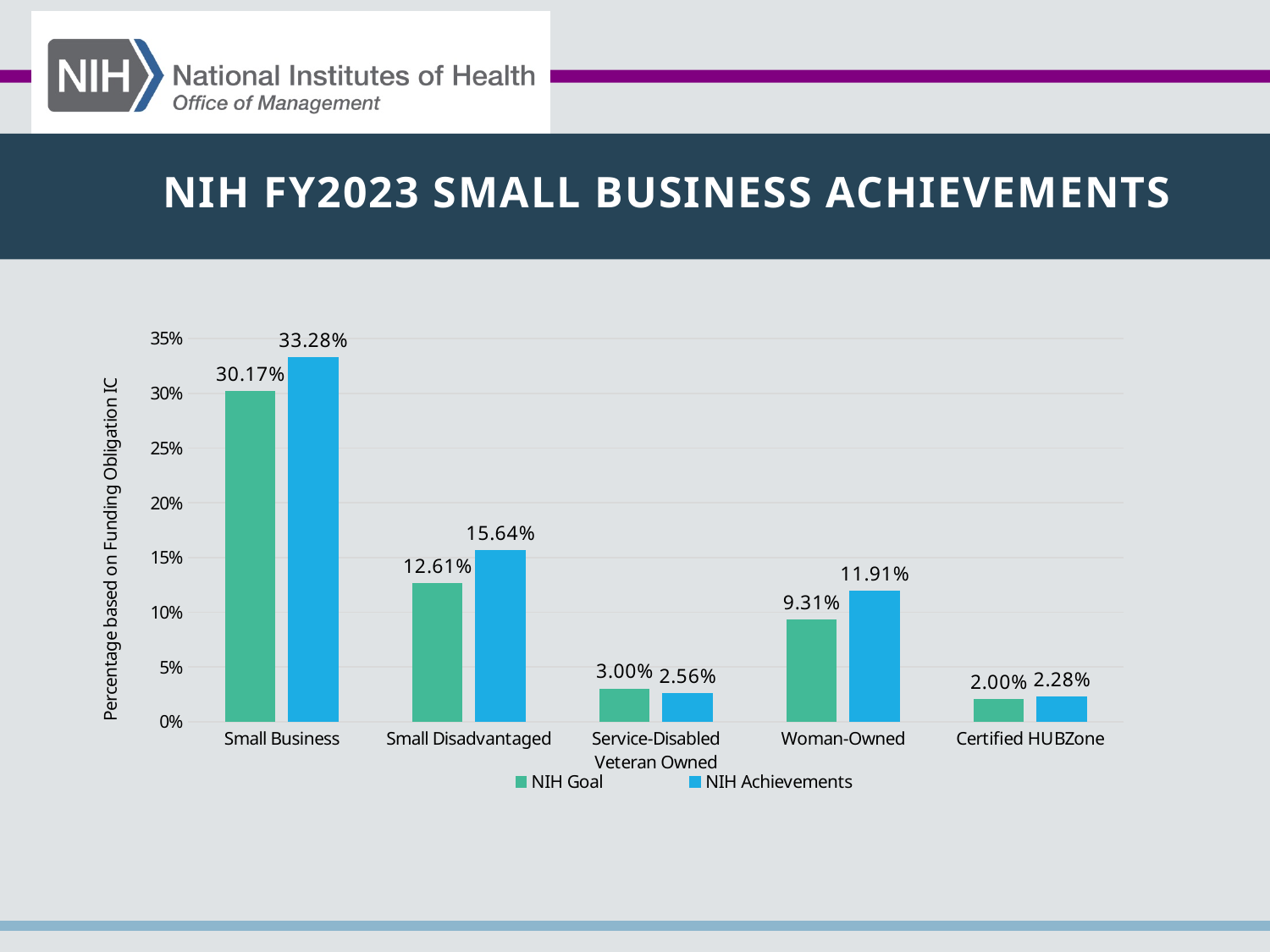
What is the difference between the NIH Achievements and NIH Goal values for Small Disadvantaged? 3.03% Which is larger for Service-Disabled Veteran Owned, the NIH Goal or the NIH Achievements value? NIH Goal What is the y-axis label of the chart? Percentage based on Funding Obligation IC How many series does the legend list? 2 What is the NIH Achievements value for Small Business? 33.28% What is the NIH Goal value for Woman-Owned? 9.31% What kind of chart is shown on the slide? Bar chart Which series is shown in blue? NIH Achievements How many categories are shown on the x axis? 5 What is the NIH Achievements value for Service-Disabled Veteran Owned? 2.56% Which category has the lowest NIH Achievements value? Certified HUBZone Which category has the highest NIH Goal value? Small Business